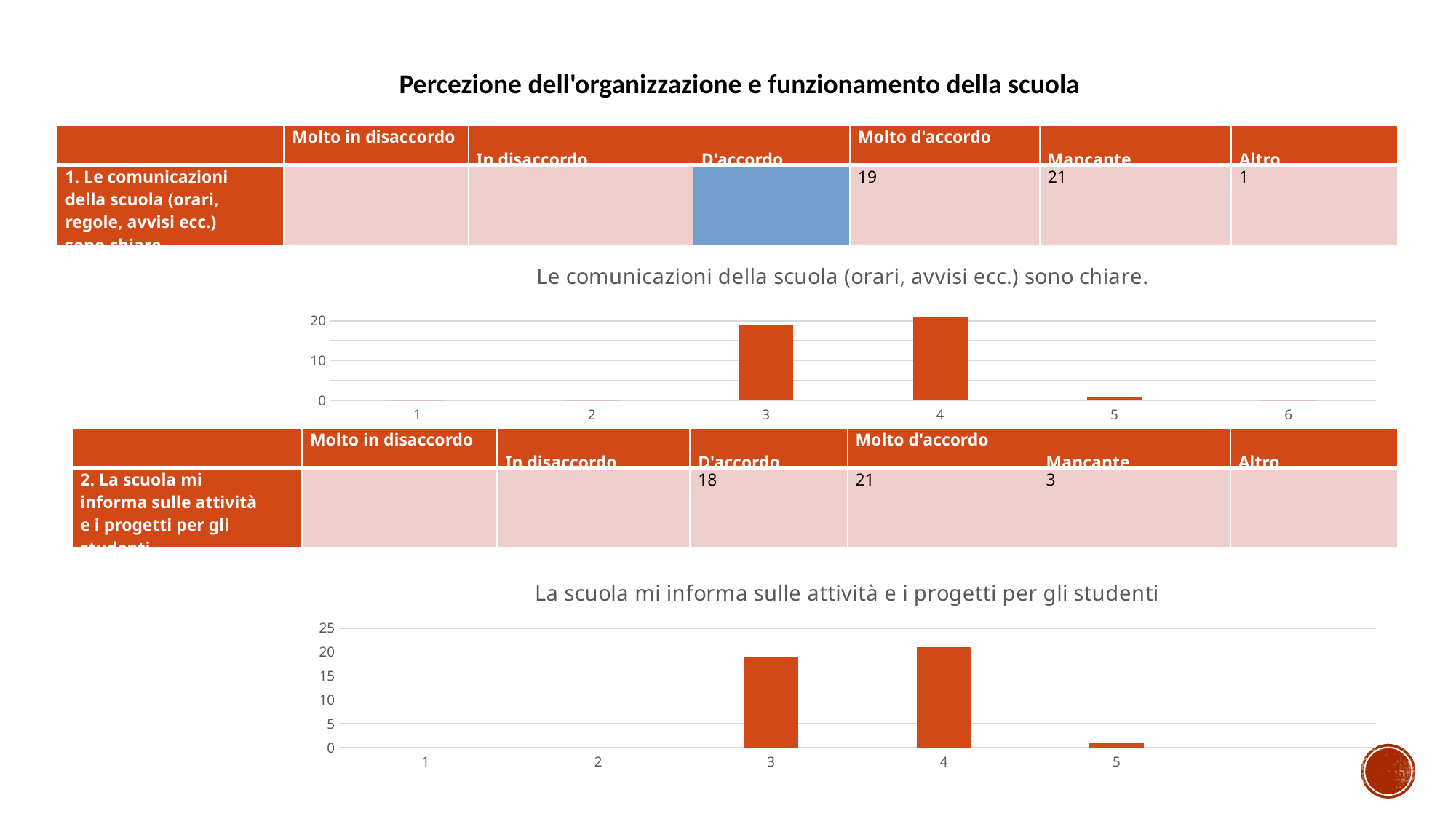
In the bottom chart 'La scuola mi informa sulle attività e i progetti per gli studenti', is the value for category 4 greater or less than 15? greater In the bottom chart 'La scuola mi informa sulle attività e i progetti per gli studenti', which is larger, the value for category 3 or category 5? category 3 In the top chart 'Le comunicazioni della scuola (orari, avvisi ecc.) sono chiare.', is the value for category 5 greater or less than 10? less What kind of chart is the top chart titled 'Le comunicazioni della scuola (orari, avvisi ecc.) sono chiare.'? bar chart How many categories are shown on the x axis of the top chart 'Le comunicazioni della scuola (orari, avvisi ecc.) sono chiare.'? 6 What is the highest tick value shown on the y axis of the bottom chart 'La scuola mi informa sulle attività e i progetti per gli studenti'? 25 What is the title of the bottom chart on the slide? La scuola mi informa sulle attività e i progetti per gli studenti In the top chart 'Le comunicazioni della scuola (orari, avvisi ecc.) sono chiare.', which category has the tallest bar? 4 In the bottom chart 'La scuola mi informa sulle attività e i progetti per gli studenti', which category has the tallest bar? 4 In the top chart 'Le comunicazioni della scuola (orari, avvisi ecc.) sono chiare.', is the value for category 3 greater or less than 10? greater How many categories are shown on the x axis of the bottom chart 'La scuola mi informa sulle attività e i progetti per gli studenti'? 5